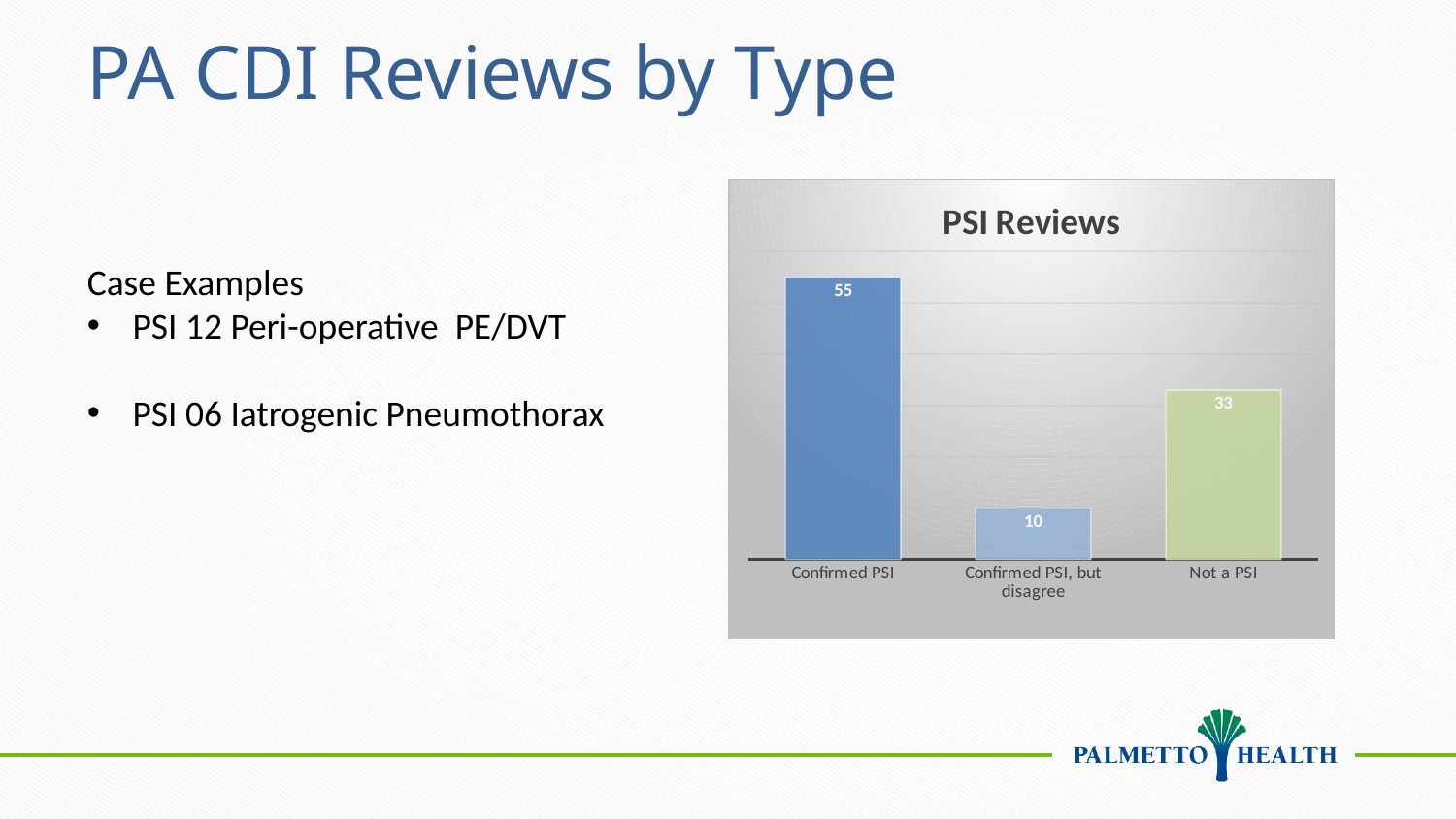
What kind of chart is the PSI Reviews chart? Bar chart Which category has the highest value in the PSI Reviews chart? Confirmed PSI How many categories are shown in the PSI Reviews chart? 3 What is the value for Confirmed PSI in the PSI Reviews chart? 55 Which category has the lowest value in the PSI Reviews chart? Confirmed PSI, but disagree Which is larger in the PSI Reviews chart: Not a PSI or Confirmed PSI, but disagree? Not a PSI What is the difference between the values for Not a PSI and Confirmed PSI, but disagree in the PSI Reviews chart? 23 What is the title of the chart on the slide? PSI Reviews What colour is the Not a PSI bar in the PSI Reviews chart? Green What is the value for Not a PSI in the PSI Reviews chart? 33 What is the value for Confirmed PSI, but disagree in the PSI Reviews chart? 10 What is the difference between the values for Confirmed PSI and Not a PSI in the PSI Reviews chart? 22